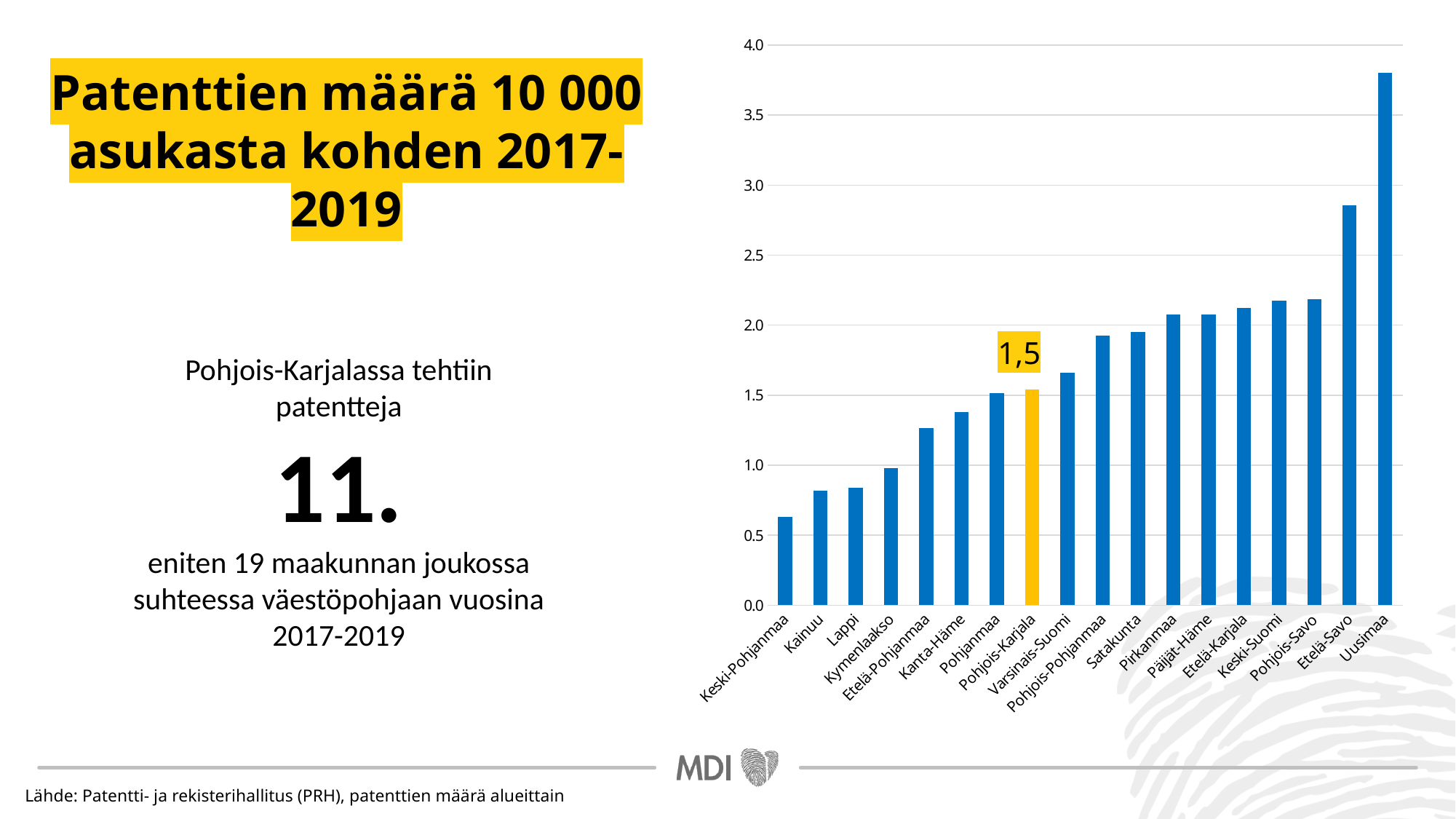
Which region has the lowest bar? Keski-Pohjanmaa Do the values rise or fall from left to right along the x axis? Rise Which has a larger value, Uusimaa or Etelä-Savo? Uusimaa Is the value for Keski-Pohjanmaa greater or less than 0.5? greater How many regions are shown on the x axis? 18 Is the value for Uusimaa greater or less than 3.5? greater Is the value for Etelä-Savo greater or less than 3.0? less What kind of chart is shown on the slide? Bar chart Which region has the highest bar? Uusimaa What is the value shown for Pohjois-Karjala? 1,5